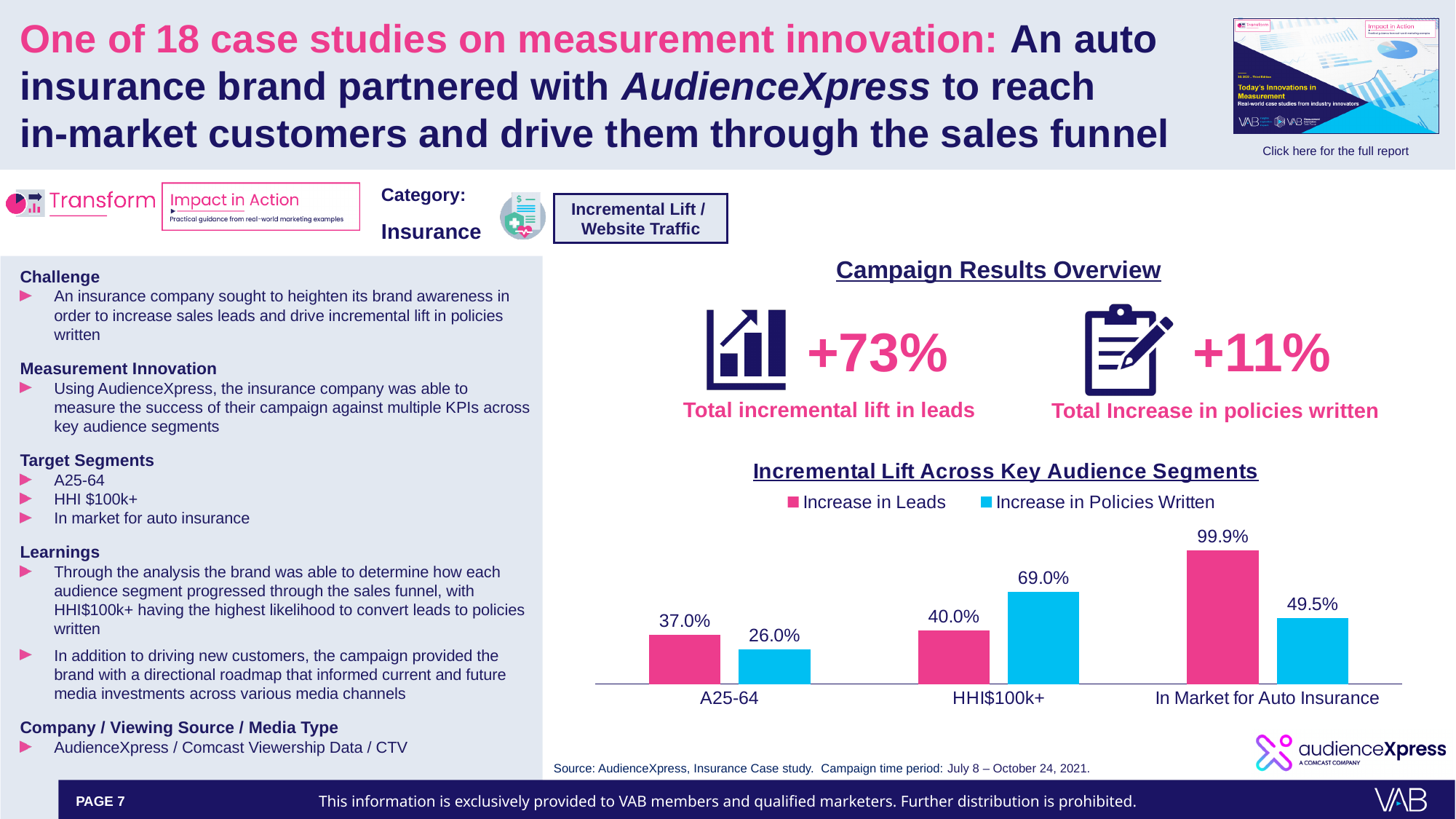
What is the Increase in Policies Written value for the A25-64 segment? 26.0% What is the Increase in Leads value for the In Market for Auto Insurance segment? 99.9% What is the title of the chart? Incremental Lift Across Key Audience Segments How many audience segments are shown on the x axis of the chart? 3 For the HHI$100k+ segment, which is larger: Increase in Leads or Increase in Policies Written? Increase in Policies Written What kind of chart is used to show Incremental Lift Across Key Audience Segments? Bar chart What is the Increase in Policies Written value for the HHI$100k+ segment? 69.0% Which audience segment has the highest Increase in Leads? In Market for Auto Insurance How many series does the chart legend list? 2 What is the Increase in Leads value for the A25-64 segment? 37.0% Which audience segment has the lowest Increase in Policies Written? A25-64 What is the difference between the Increase in Leads and the Increase in Policies Written for the In Market for Auto Insurance segment? 50.4%